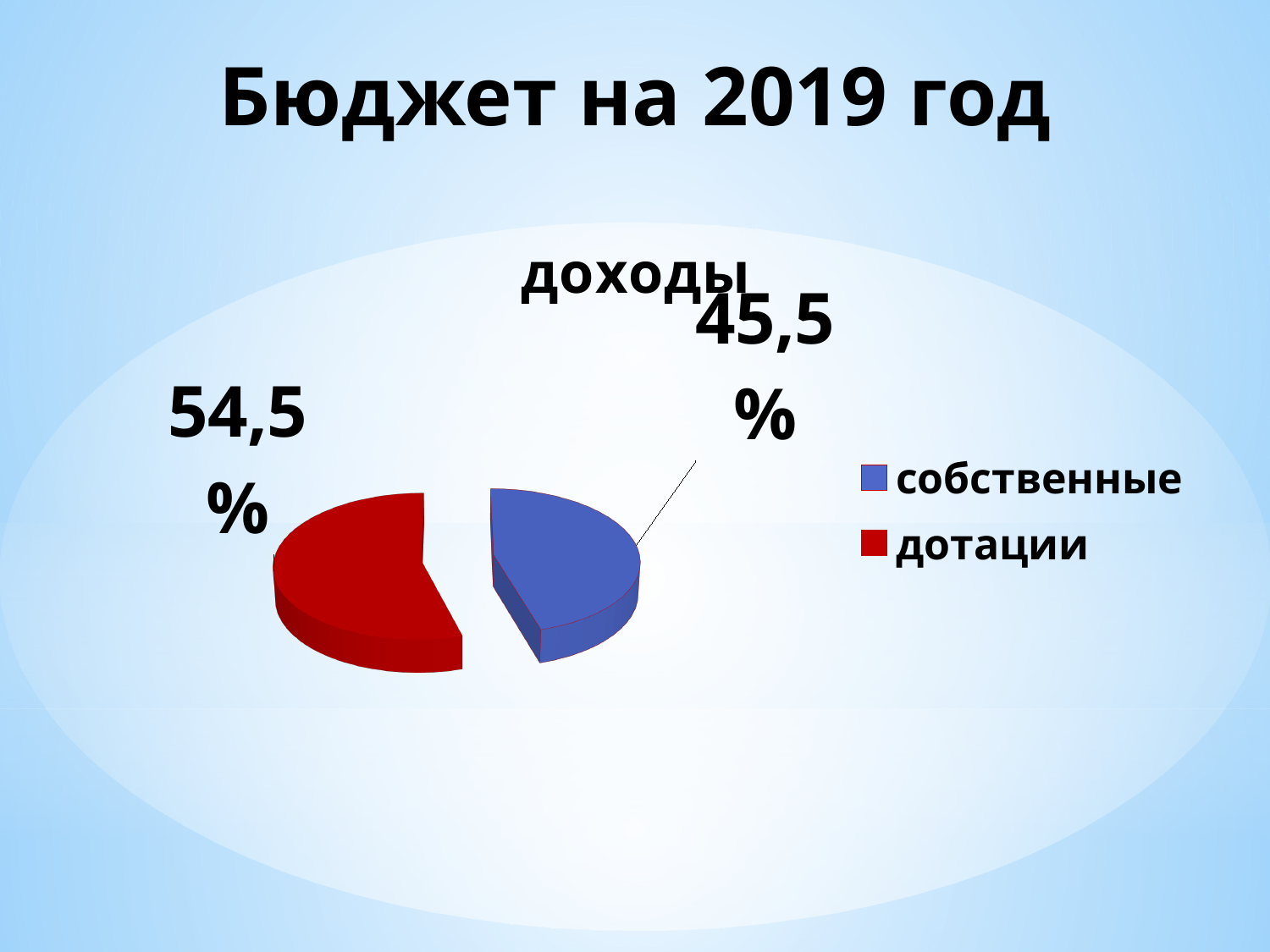
What is the difference between the дотации share and the собственные share? 9 percentage points What share of the pie does собственные take? 45,5% What kind of chart is shown on the slide? pie chart Which is larger, собственные or дотации? дотации Which slice of the pie is the smallest? собственные What colour is the дотации slice? red Is the share for собственные greater or less than 50%? less What share of the pie does дотации take? 54,5% How many entries does the legend list? 2 Which slice of the pie is the largest? дотации How many slices does the pie chart have? 2 What is the title of the chart? доходы